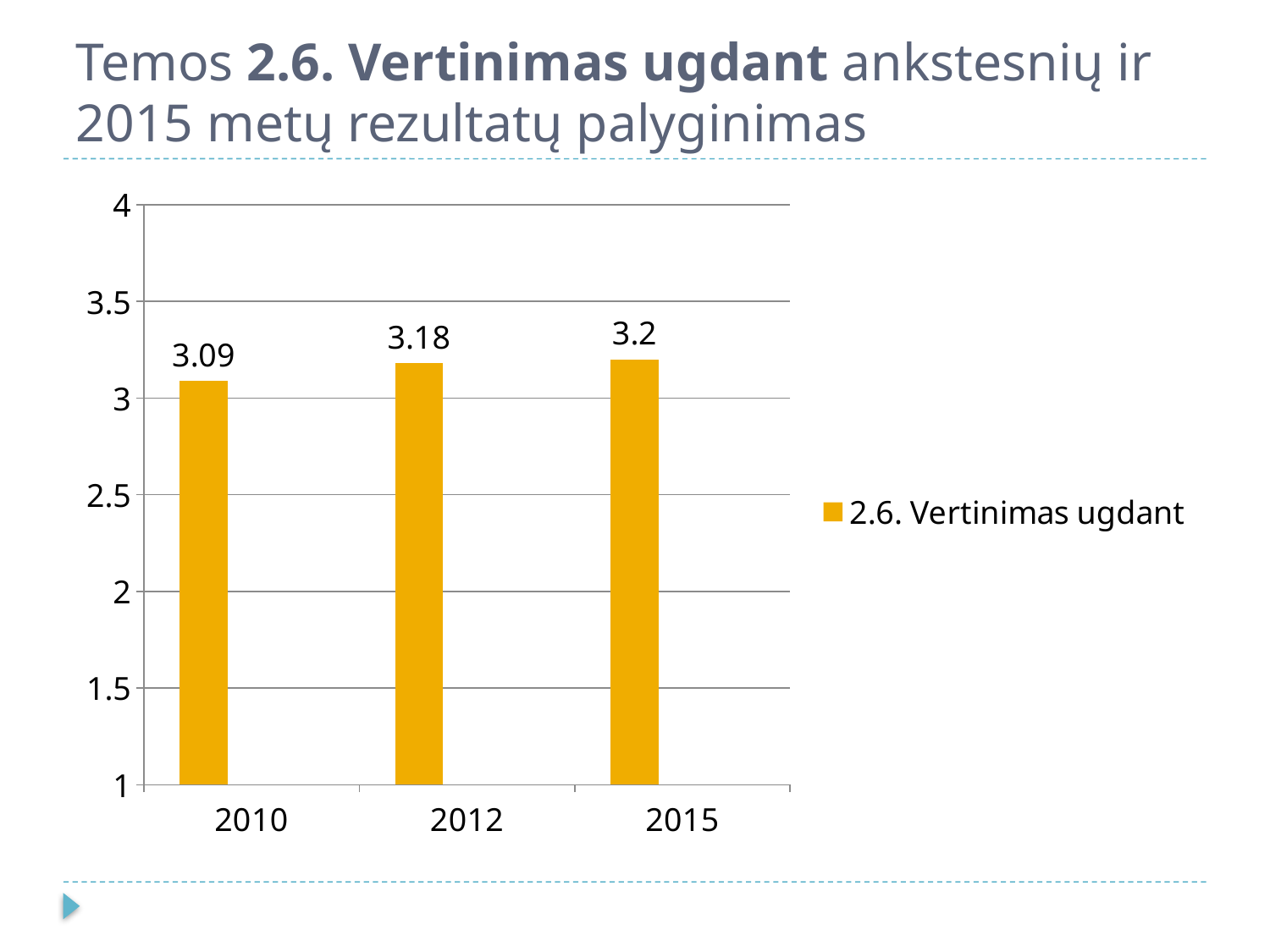
What is the difference between the values for 2012 and 2010? 0.09 Which is larger, the value for 2010 or the value for 2012? 2012 What is the difference between the values for 2015 and 2010? 0.11 Is the value for 2010 greater or less than 3? greater What is the value for 2010? 3.09 Which year has the highest value? 2015 What is the value for 2015? 3.2 What is the value for 2012? 3.18 What kind of chart is shown on the slide? bar chart How many years are shown on the x axis? 3 Which year has the lowest value? 2010 Do the values rise or fall from 2010 to 2015? rise